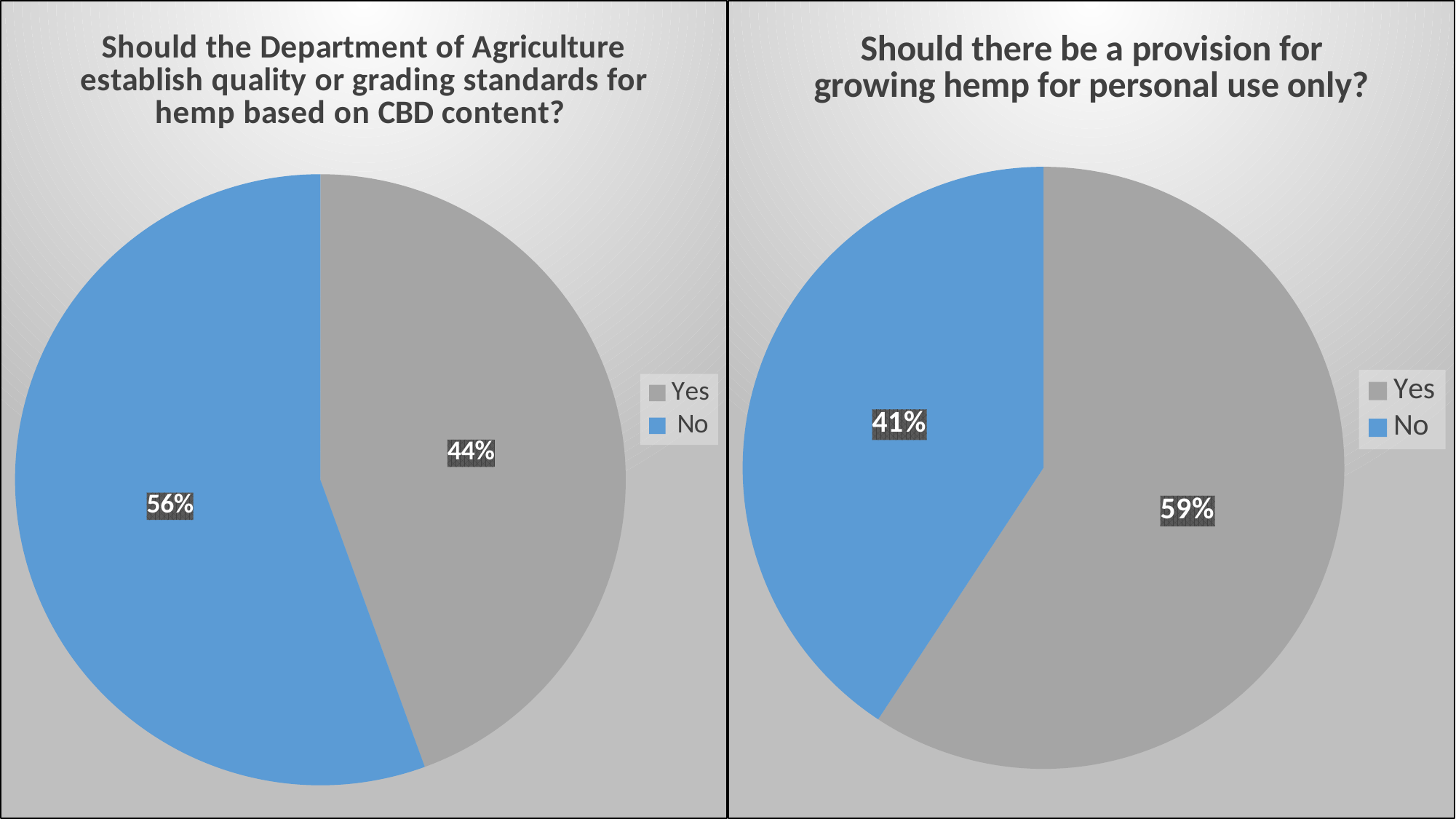
How many slices does the right chart (provision for growing hemp for personal use only) have? 2 In the left chart (Department of Agriculture quality or grading standards), what percentage answered No? 56% In the right chart (provision for growing hemp for personal use only), is the Yes share larger or smaller than the No share? larger In the left chart (Department of Agriculture quality or grading standards), what is the difference between the No and Yes shares? 12% In the right chart (provision for growing hemp for personal use only), what percentage answered Yes? 59% In the left chart (Department of Agriculture quality or grading standards), which response has the larger share? No In the left chart (Department of Agriculture quality or grading standards), which colour represents the No response? blue What kind of chart is used on the left side of the slide? pie chart In the left chart (Department of Agriculture quality or grading standards), what percentage answered Yes? 44% In the right chart (provision for growing hemp for personal use only), what percentage answered No? 41% In the right chart (provision for growing hemp for personal use only), what is the difference between the Yes and No shares? 18% In the right chart (provision for growing hemp for personal use only), which response has the smaller share? No